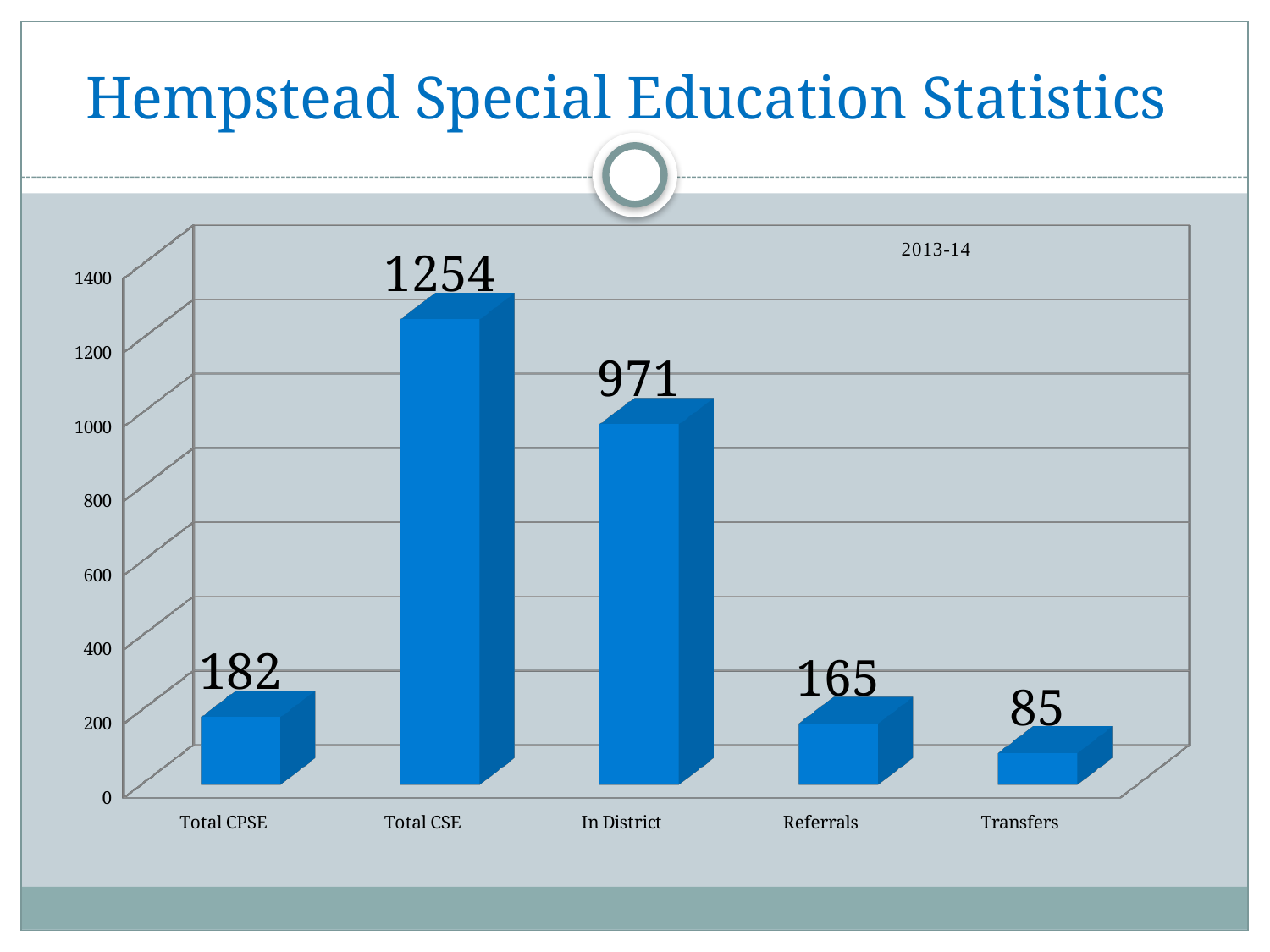
What kind of chart is shown on the slide? Bar chart What is the difference between Total CPSE and Referrals? 17 Which is larger, Total CPSE or Referrals? Total CPSE Which category has the lowest value? Transfers What is the value for In District? 971 How many categories are shown on the x axis? 5 What is the value for Referrals? 165 What is the value for Transfers? 85 What is the value for Total CSE? 1254 What is the difference between Total CSE and In District? 283 What is the title of the slide? Hempstead Special Education Statistics Which category has the highest value? Total CSE